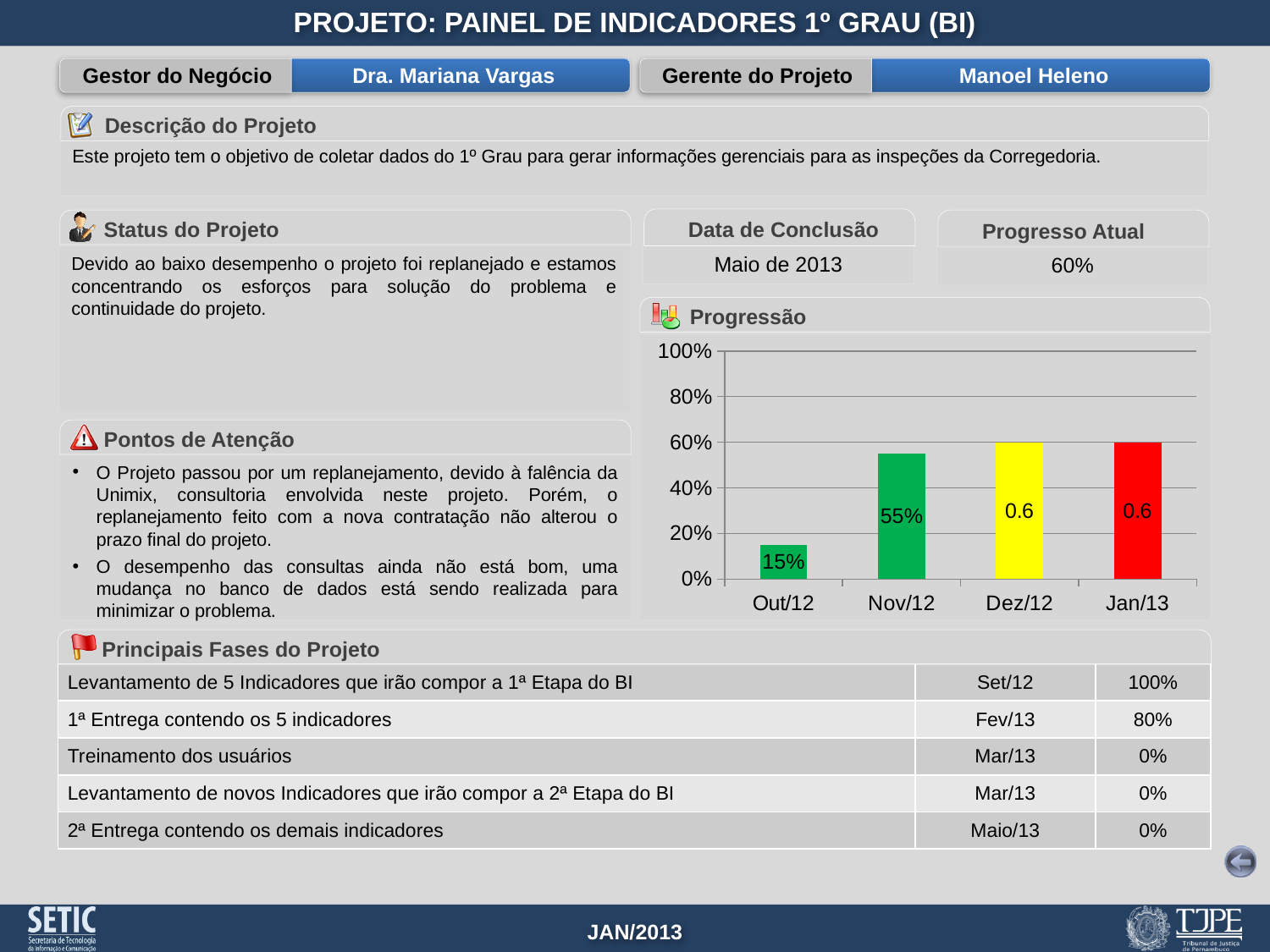
What is the difference between the values for Nov/12 and Out/12 in the Progressão chart? 40% Do the values in the Progressão chart rise or fall from Out/12 to Jan/13? rise What data label is shown on the Jan/13 bar in the Progressão chart? 0.6 What colour is the Jan/13 bar in the Progressão chart? red In the Progressão chart, is the value for Nov/12 greater or less than 40%? greater What kind of chart is the Progressão chart? bar chart What data label is shown on the Dez/12 bar in the Progressão chart? 0.6 What is the value shown for Nov/12 in the Progressão chart? 55% How many months are shown on the x axis of the Progressão chart? 4 What is the value shown for Out/12 in the Progressão chart? 15% Which month has the lowest value in the Progressão chart? Out/12 In the Progressão chart, which is larger: the value for Out/12 or the value for Nov/12? Nov/12